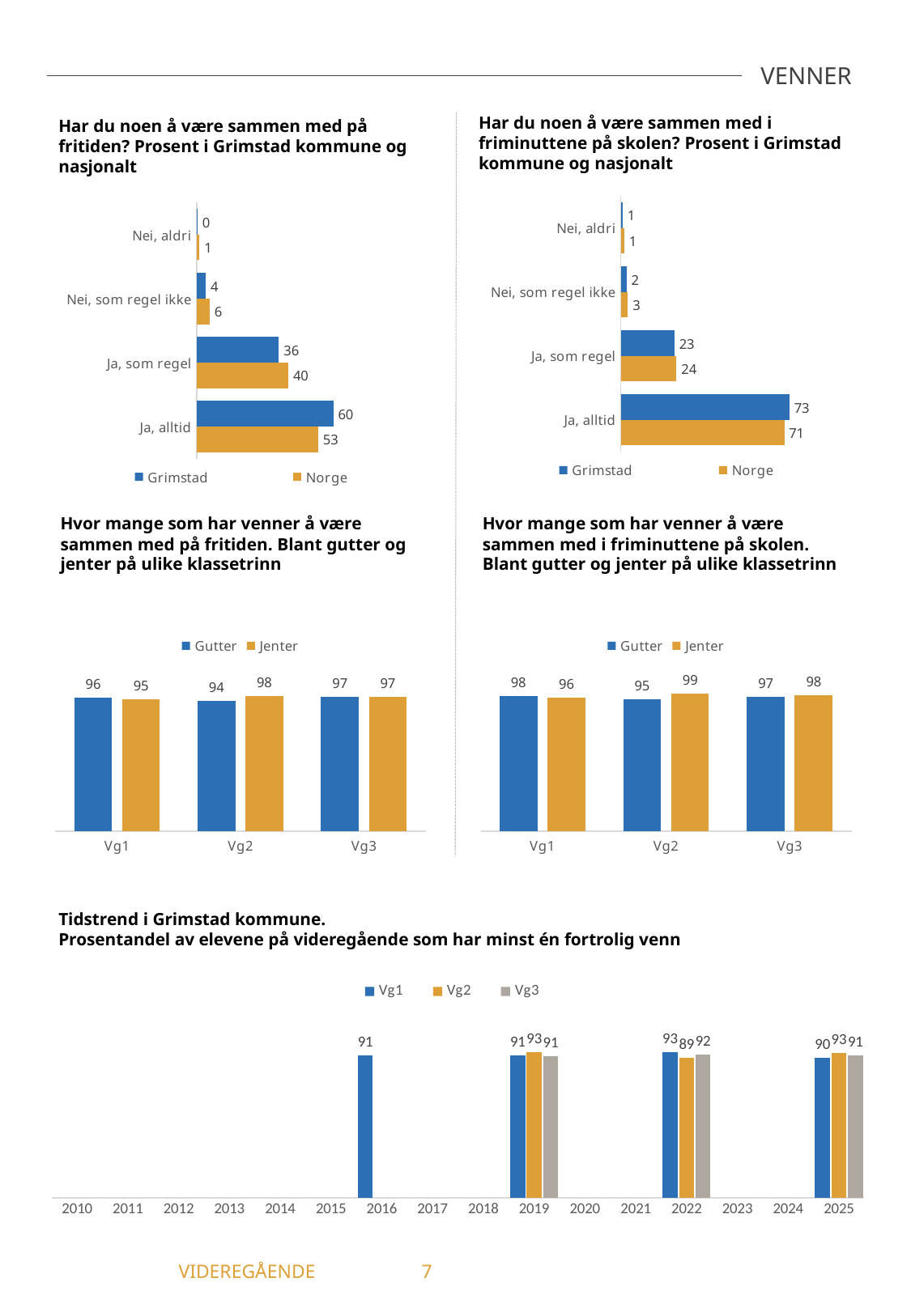
In the middle-left chart (Hvor mange som har venner å være sammen med på fritiden), what is the value for Jenter at Vg2? 98 In the bottom chart (Tidstrend i Grimstad kommune), what is the value for Vg2 in 2022? 89 In the middle-right chart (Hvor mange som har venner å være sammen med i friminuttene på skolen), what is the difference between Jenter and Gutter at Vg2? 4 In the top-left chart (Har du noen å være sammen med på fritiden?), which category has the highest value for Norge? Ja, alltid In the top-left chart (Har du noen å være sammen med på fritiden?), what is the difference between the Norge and Grimstad values for 'Ja, som regel'? 4 In the top-left chart (Har du noen å være sammen med på fritiden?), what is the value for Grimstad in the 'Ja, alltid' category? 60 In the top-right chart (Har du noen å være sammen med i friminuttene på skolen?), which is larger for 'Ja, som regel': Grimstad or Norge? Norge In the top-right chart (Har du noen å være sammen med i friminuttene på skolen?), what is the value for Norge in the 'Ja, alltid' category? 71 What kind of chart is the bottom chart (Tidstrend i Grimstad kommune)? Bar chart In the middle-left chart (Hvor mange som har venner å være sammen med på fritiden), which group has the lowest value across all bars? Gutter at Vg2 In the top-right chart (Har du noen å være sammen med i friminuttene på skolen?), how many series does the legend list? 2 In the middle-right chart (Hvor mange som har venner å være sammen med i friminuttene på skolen), how many class levels are shown on the x axis? 3